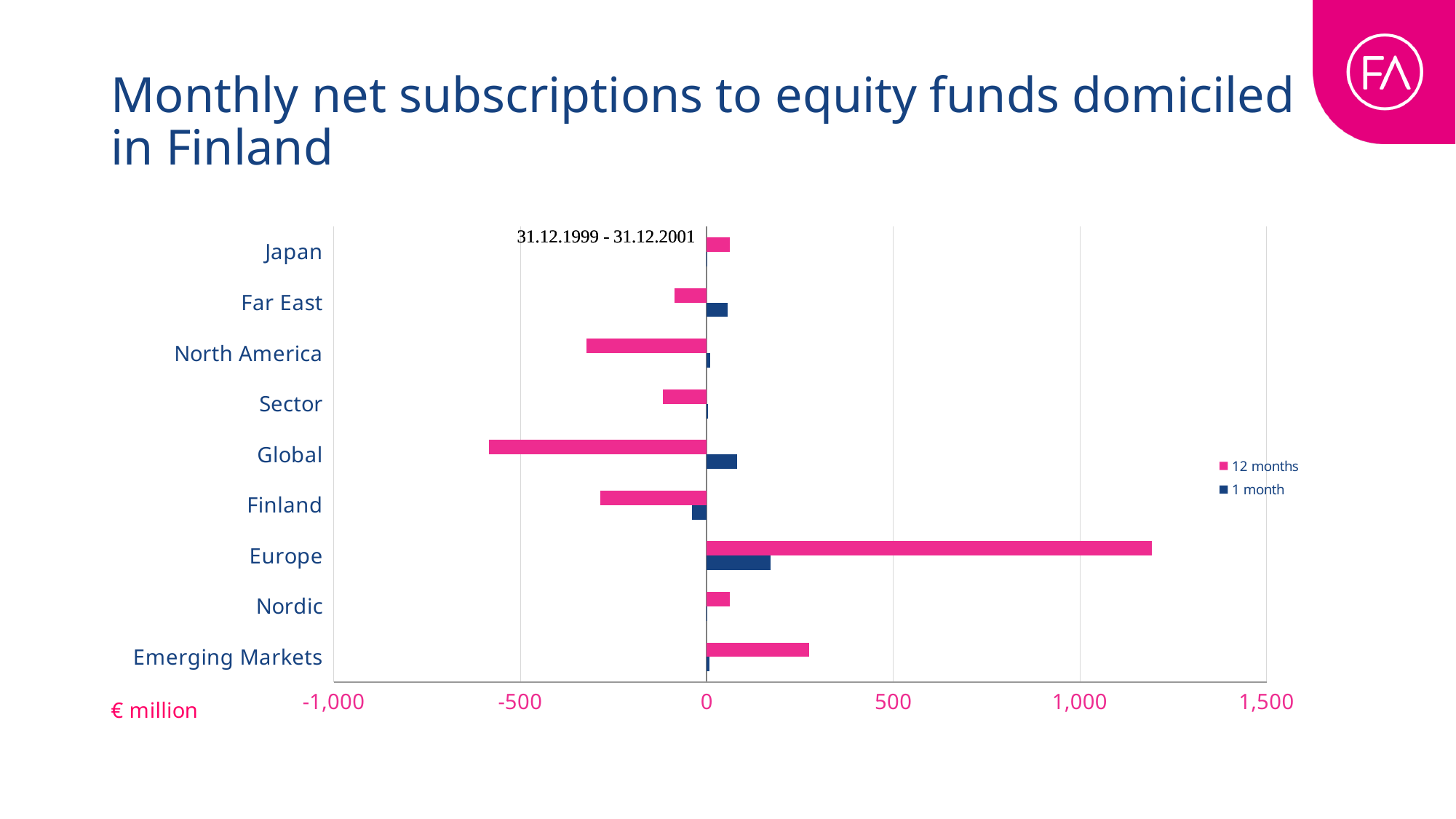
How many categories are shown on the chart? 9 Which category has the highest 12 months value? Europe What kind of chart is shown on the slide? bar chart Is the 12 months value for Global greater or less than -500? less What date range is printed on the chart? 31.12.1999 - 31.12.2001 How many series does the legend list? 2 Which is larger, the 12 months value for Europe or for Emerging Markets? Europe Is the 12 months value for Emerging Markets greater or less than 500? less Is the 12 months value for Europe greater or less than 1,000? greater What unit is shown for the x axis of the chart? € million Which category has the lowest 12 months value? Global